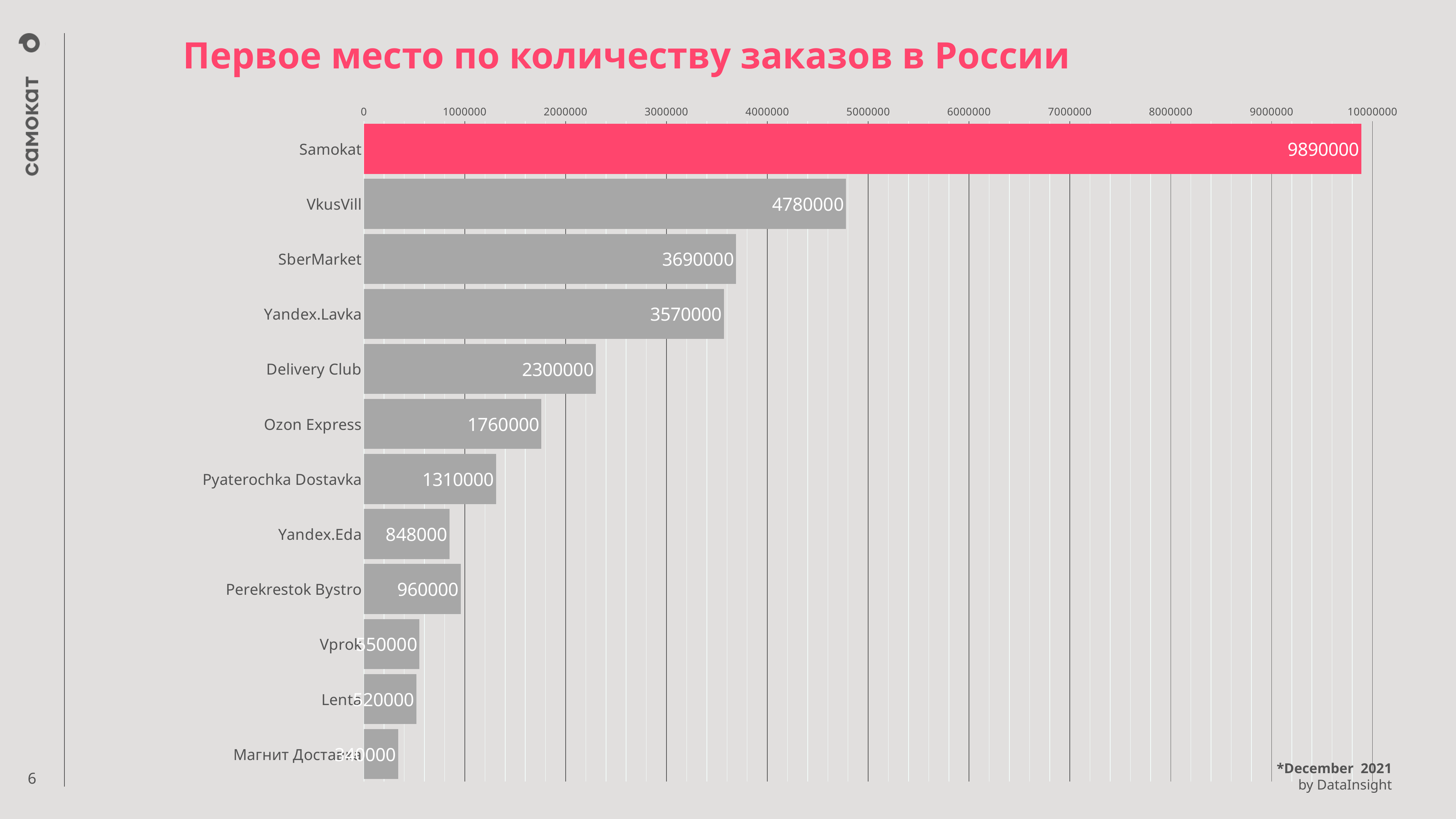
What is the value for VkusVill? 4780000 What is the title of the chart? Первое место по количеству заказов в России What is the value for Yandex.Eda? 848000 How many companies are shown in the chart? 12 Which is larger, the value for Perekrestok Bystro or the value for Yandex.Eda? Perekrestok Bystro Is the value for Delivery Club greater or less than 2000000? greater What type of chart is shown on the slide? bar chart What is the value for Yandex.Lavka? 3570000 What is the value for Samokat? 9890000 Which company has the lowest number of orders? Магнит Доставка What is the difference between the values for Samokat and VkusVill? 5110000 Which company has the highest number of orders? Samokat